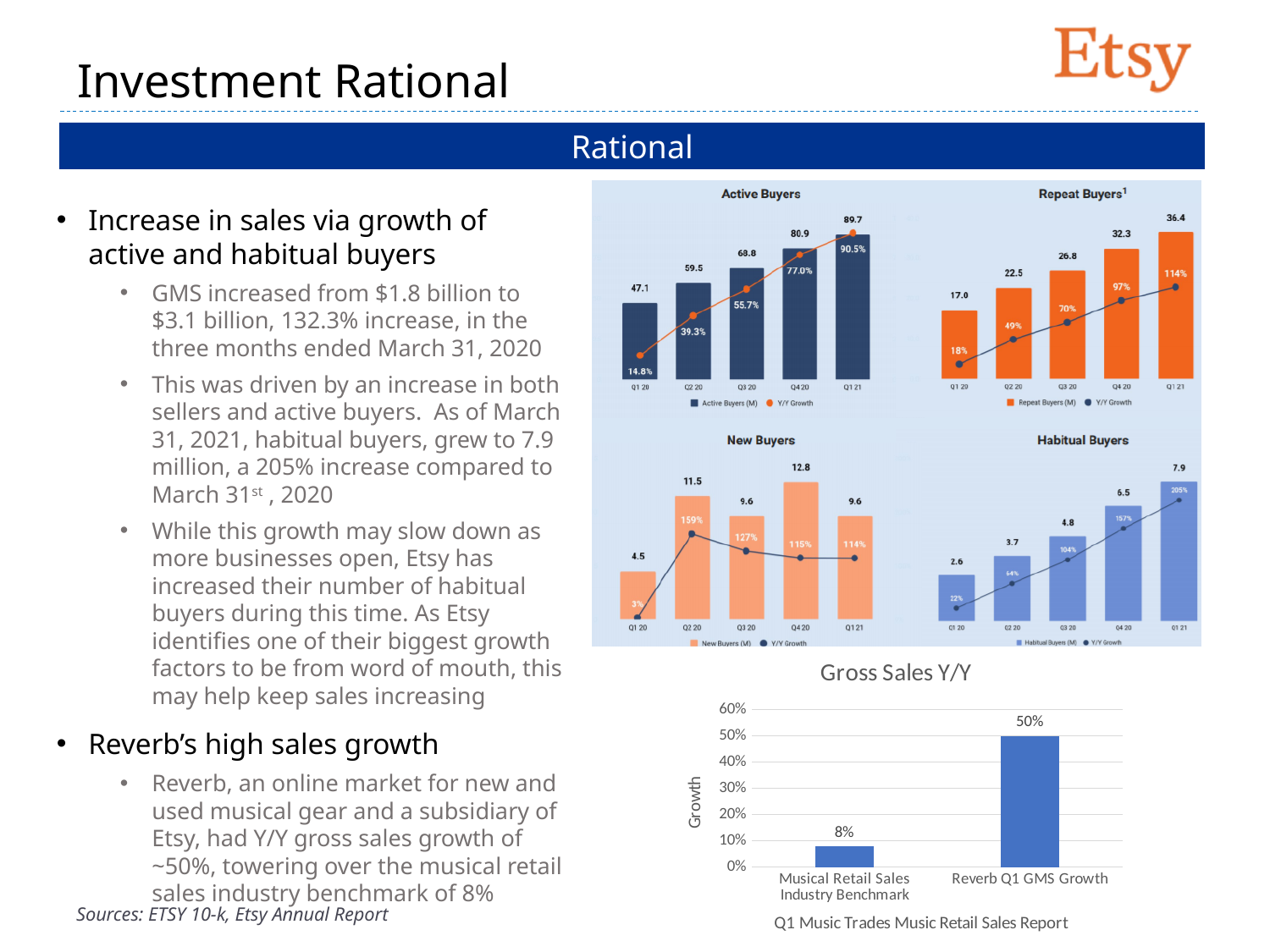
In the Gross Sales Y/Y chart, how many categories are plotted? 2 In the Active Buyers chart, how many series does the legend list? 2 In the Gross Sales Y/Y chart, what is the value for Reverb Q1 GMS Growth? 50% In the Active Buyers chart, what is the value for Q1 21? 89.7 In the Gross Sales Y/Y chart, what is the difference between Reverb Q1 GMS Growth and the Musical Retail Sales Industry Benchmark? 42% In the Habitual Buyers chart, what is the value for Q1 21? 7.9 In the Repeat Buyers chart, what is the Y/Y growth shown for Q1 21? 114% In the Gross Sales Y/Y chart, what is the value for Musical Retail Sales Industry Benchmark? 8% What kind of chart is the Gross Sales Y/Y chart? Bar chart In the New Buyers chart, which quarter has the highest number of new buyers? Q4 20 In the Active Buyers chart, which quarter has the lowest number of active buyers? Q1 20 In the Habitual Buyers chart, do the bar values rise or fall from Q1 20 to Q1 21? Rise